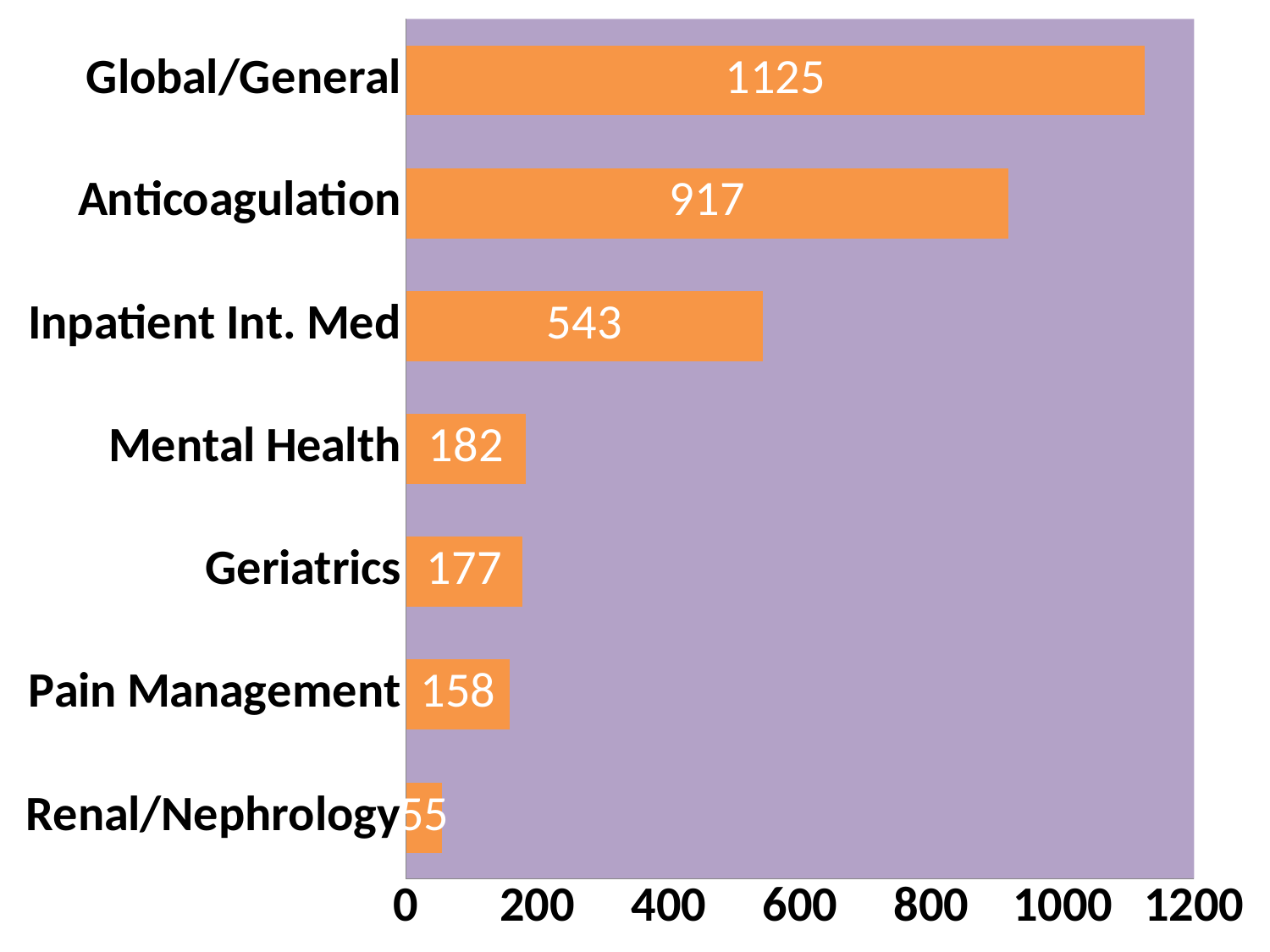
What is the difference between the values for Mental Health and Geriatrics? 5 What is the value for Global/General? 1125 What is the difference between the values for Global/General and Anticoagulation? 208 Which is larger, the value for Inpatient Int. Med or the value for Mental Health? Inpatient Int. Med What is the value for Pain Management? 158 What is the value for Inpatient Int. Med? 543 What kind of chart is this? Bar chart What is the value for Anticoagulation? 917 What colour are the bars in the chart? Orange Which category has the lowest value? Renal/Nephrology Which category has the highest value? Global/General How many categories are shown in the chart? 7